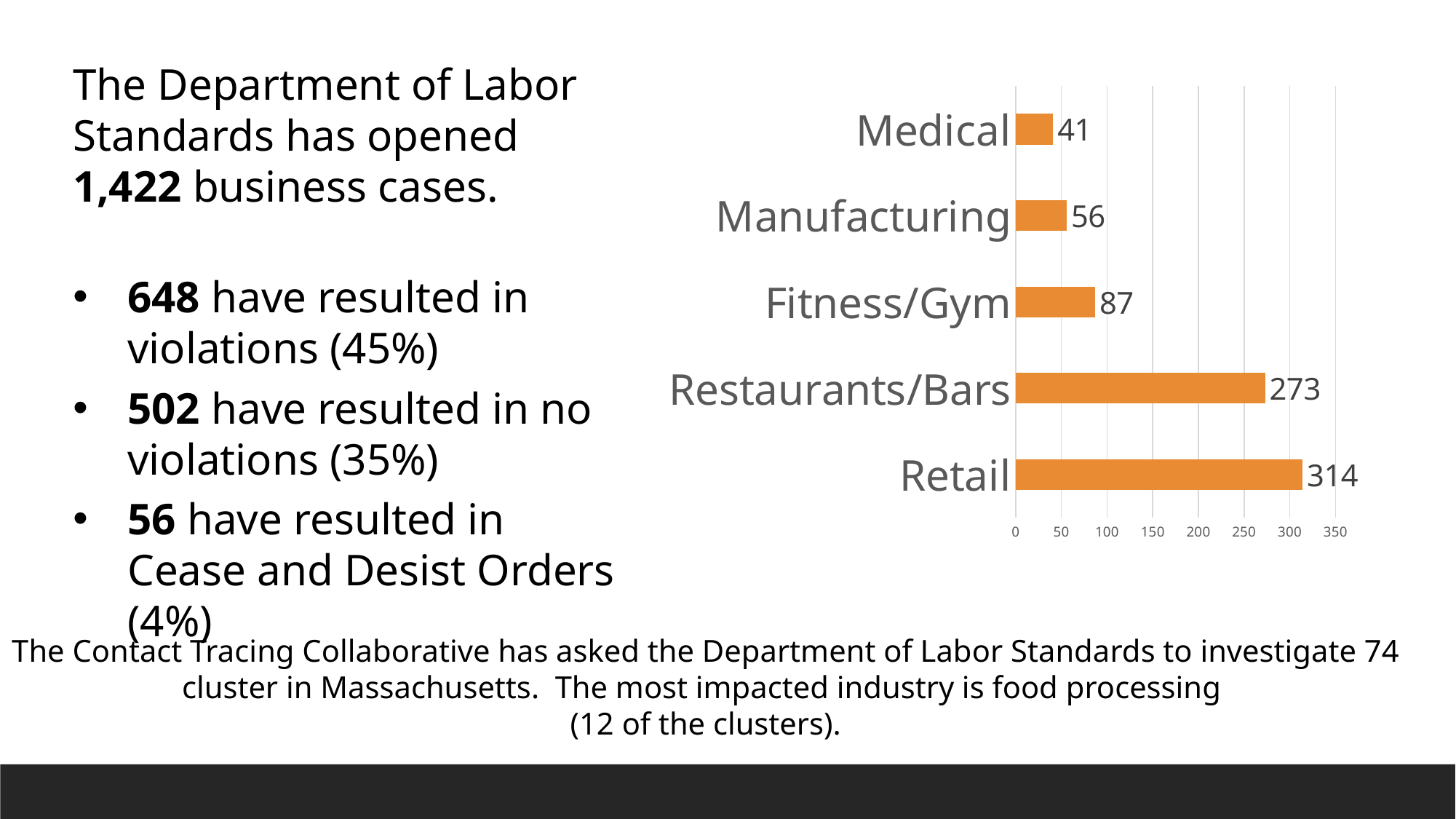
What is the highest tick value shown on the horizontal axis of the bar chart? 350 Which is larger, the value for Fitness/Gym or the value for Manufacturing? Fitness/Gym What is the value for Retail in the bar chart? 314 What is the difference between the values for Retail and Restaurants/Bars? 41 What is the value for Fitness/Gym in the bar chart? 87 What kind of chart is shown on the slide? Bar chart How many categories are shown in the bar chart? 5 Which category has the highest value in the bar chart? Retail What is the value for Restaurants/Bars in the bar chart? 273 Which category has the lowest value in the bar chart? Medical What is the difference between the values for Manufacturing and Medical? 15 What is the value for Medical in the bar chart? 41